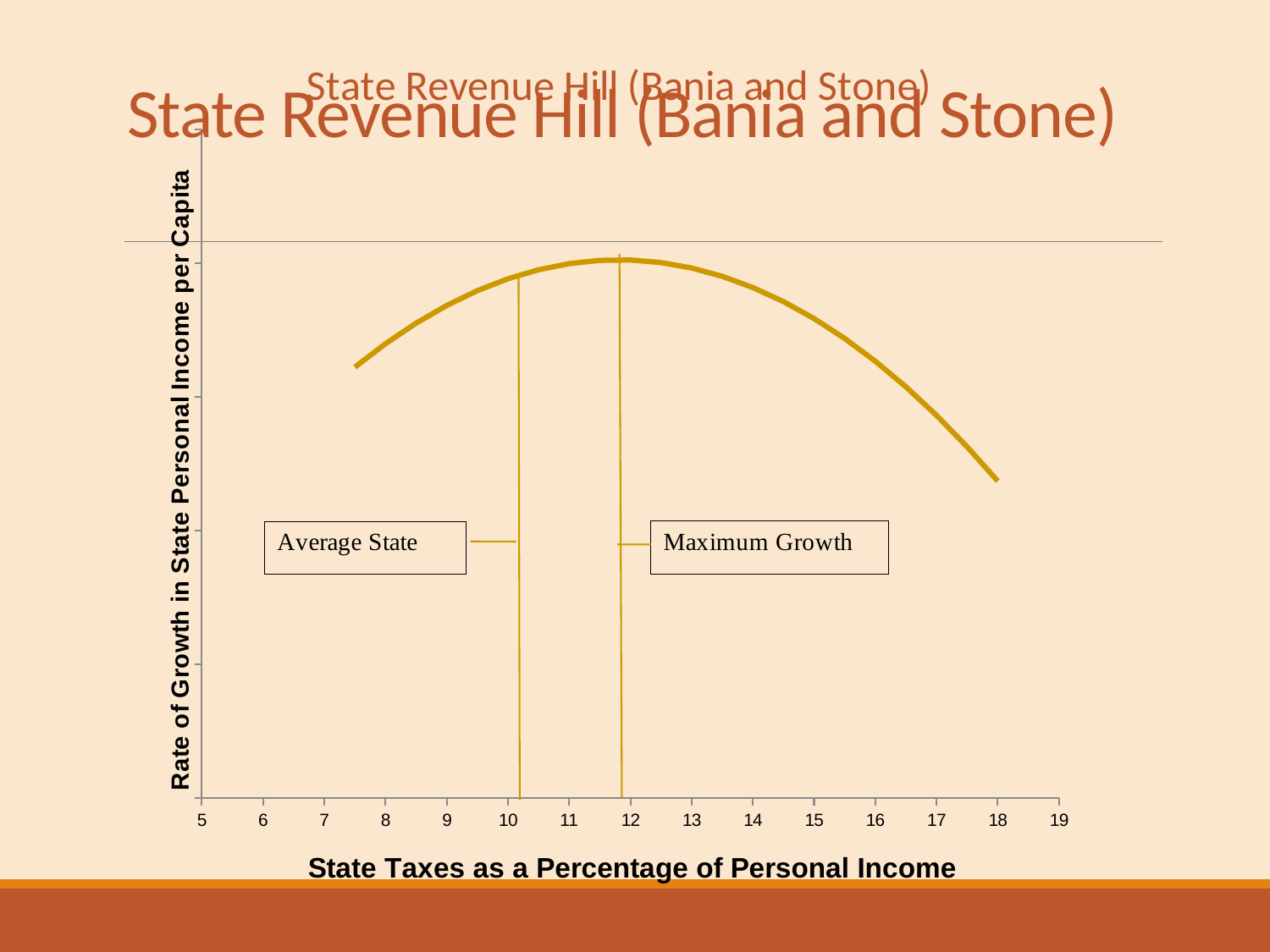
What is the highest value labelled on the x axis? 19 How many tick labels are shown on the x axis? 15 Which vertical marker is at a higher state tax percentage, Average State or Maximum Growth? Maximum Growth Is the x-axis position of the Average State line greater or less than 11? less Is the x-axis position of the Maximum Growth line greater or less than 11? greater Does the curve rise or fall as the x axis moves from 12 to 18? fall What is the label of the x axis? State Taxes as a Percentage of Personal Income What is the title of the chart? State Revenue Hill (Bania and Stone) What kind of chart is shown on the slide? line chart What is the lowest value labelled on the x axis? 5 Is the x-axis position of the Average State line greater or less than 9? greater Does the curve rise or fall as the x axis moves from 8 to 11? rise